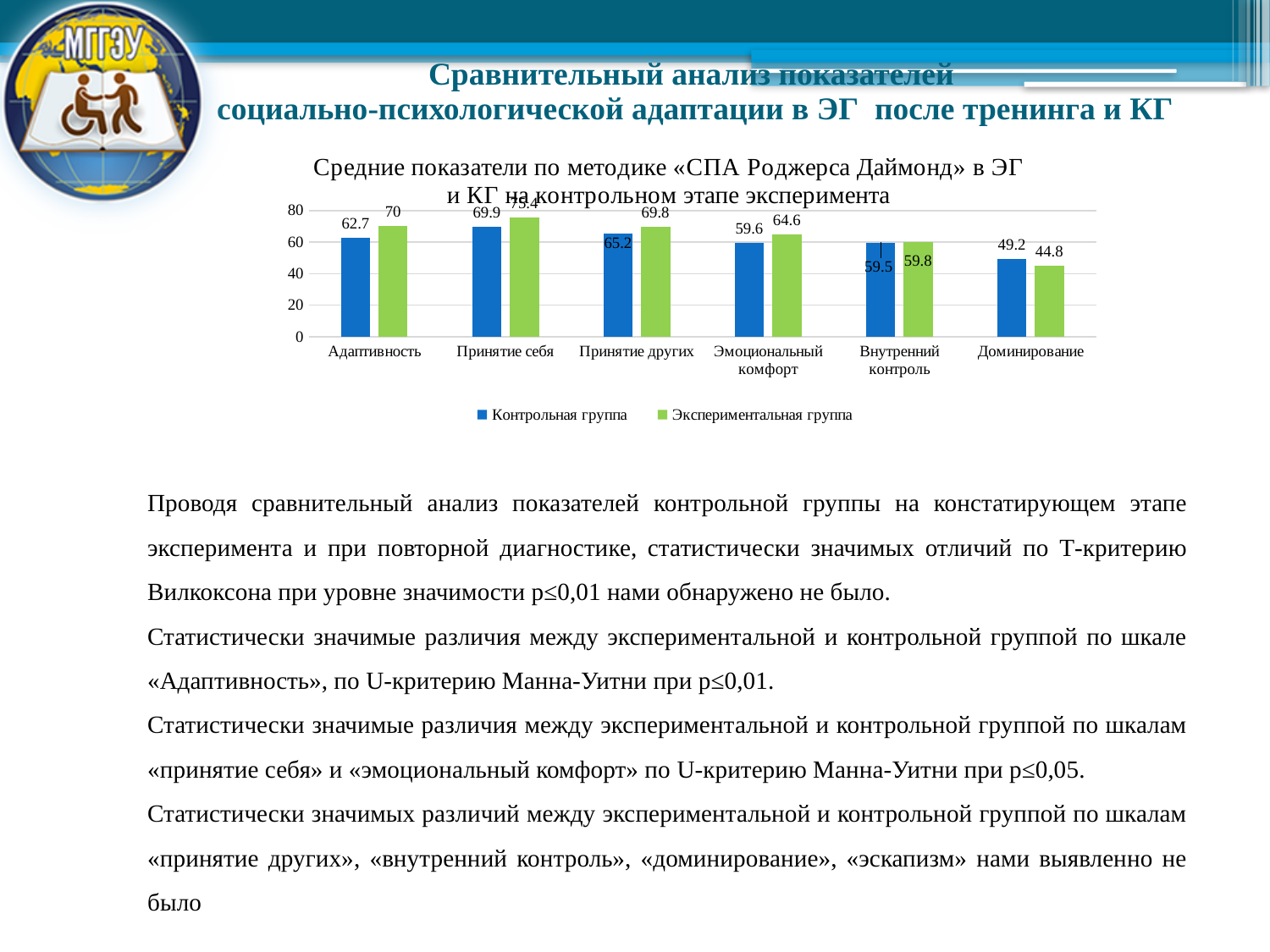
Which category has the highest value for Экспериментальная группа? Принятие себя What is the value for Контрольная группа in the Эмоциональный комфорт category? 59.6 What is the value for Экспериментальная группа in the Принятие других category? 69.8 What is the value for Экспериментальная группа in the Доминирование category? 44.8 What is the value for Контрольная группа in the Адаптивность category? 62.7 In the Доминирование category, which series has the larger value, Контрольная группа or Экспериментальная группа? Контрольная группа What is the difference between Экспериментальная группа and Контрольная группа in the Адаптивность category? 7.3 How many series does the chart legend list? 2 Which category has the lowest value for Контрольная группа? Доминирование What type of chart is shown on the slide? Bar chart What is the difference between Экспериментальная группа and Контрольная группа in the Эмоциональный комфорт category? 5 How many categories are shown on the x axis of the chart? 6